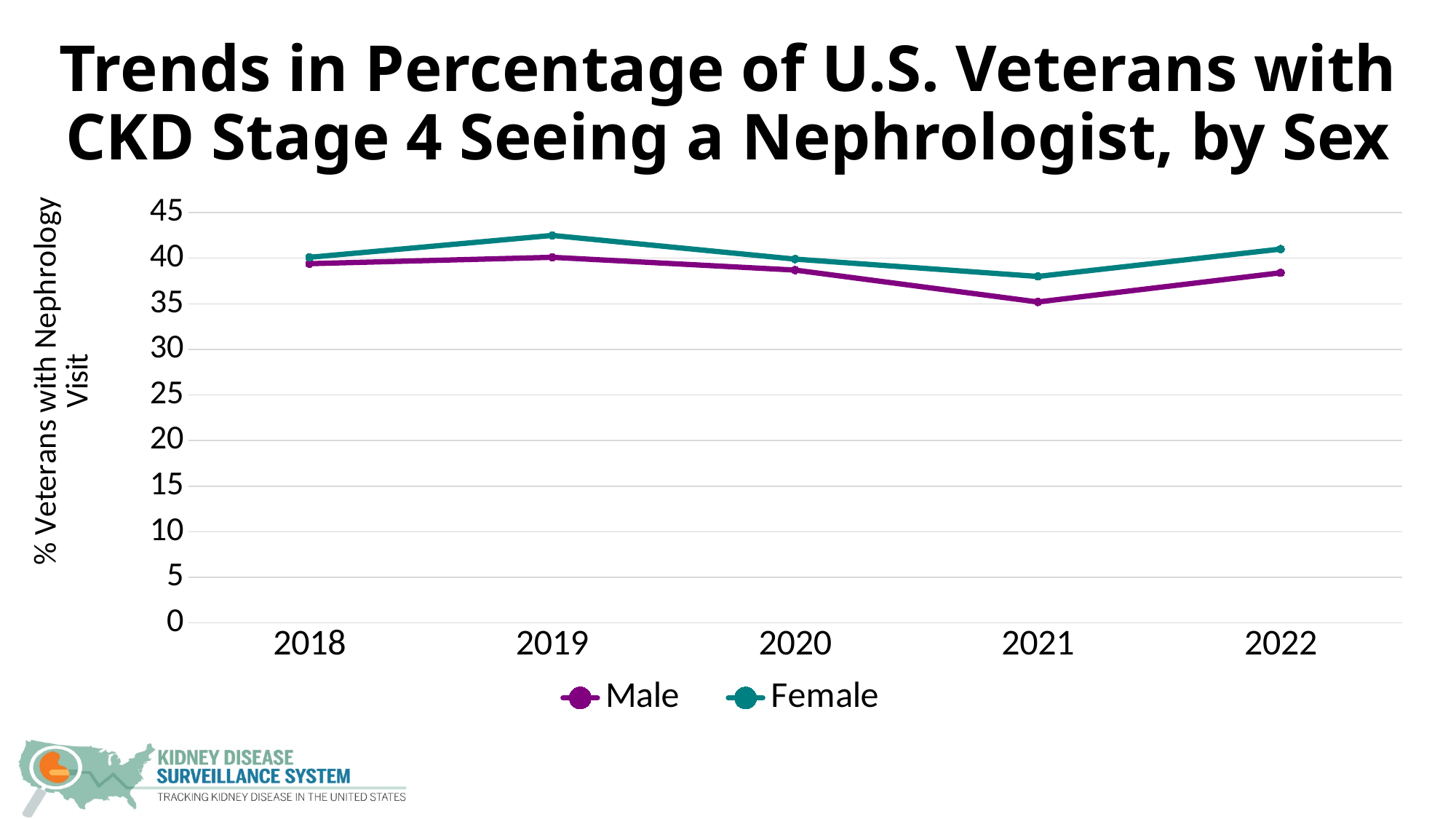
Is the Female value for 2021 greater or less than 40? less In which year is the Male series at its lowest? 2021 In which year is the Female series at its highest? 2019 How many series does the legend list? 2 In which year is the Female series at its lowest? 2021 What kind of chart is shown on the slide? line chart Is the Male value for 2021 greater or less than 40? less In 2021, which series has the larger value, Male or Female? Female Is the Female value for 2019 greater or less than 40? greater How many years are plotted on the x axis? 5 Does the Male series rise or fall from 2019 to 2021? fall What is the label of the y axis? % Veterans with Nephrology Visit